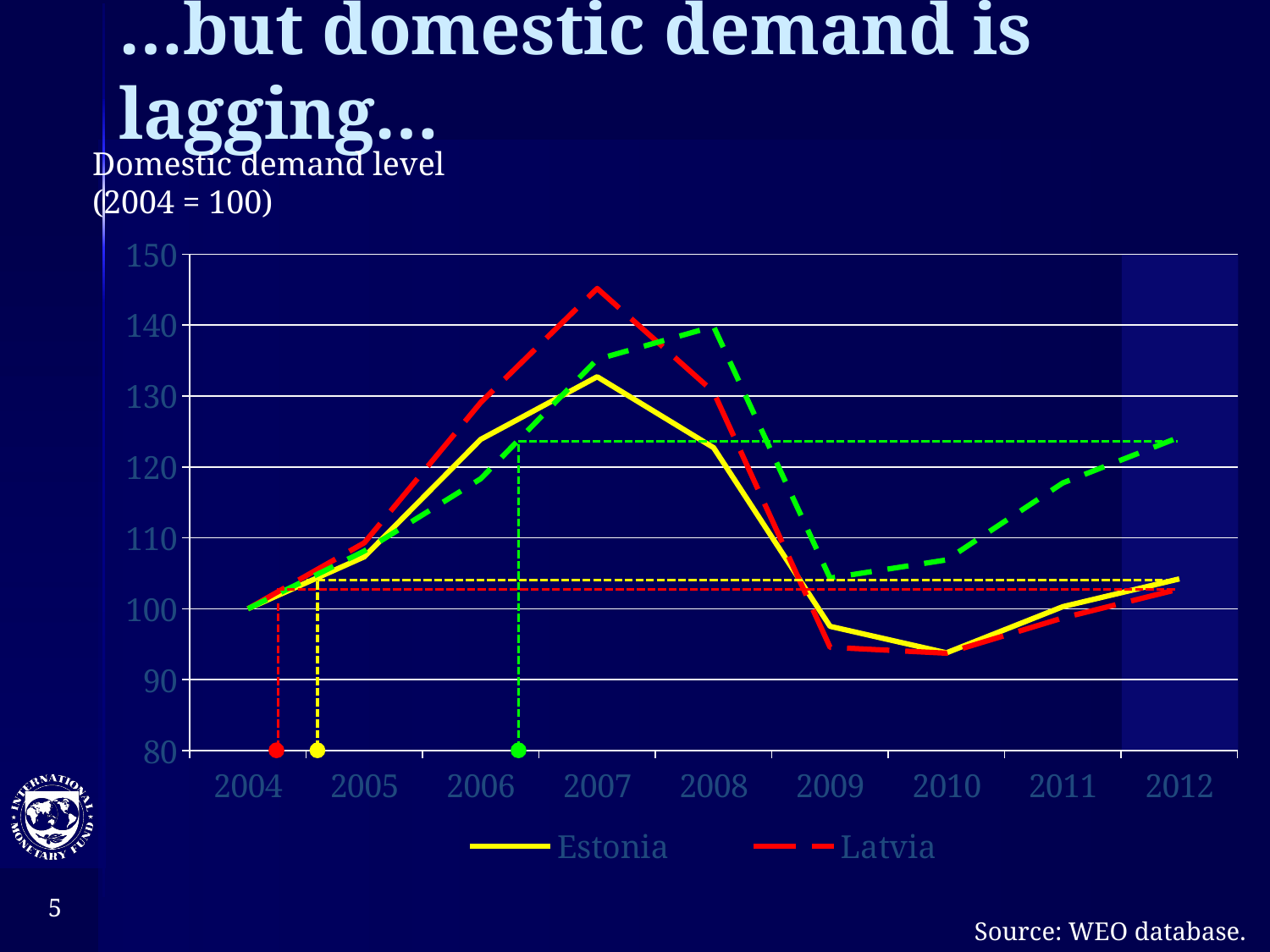
In which year is Estonia's domestic demand level at its lowest? 2010 In which year does Estonia's domestic demand level reach its highest point? 2007 How many series does the chart legend list? 2 In 2007, which series has the higher domestic demand level, Estonia or Latvia? Latvia What source is cited for the chart data? WEO database What kind of chart is shown on the slide? line chart Is the value for Latvia in 2007 greater or less than 140? greater Is the value for Estonia in 2010 greater or less than 100? less What is the domestic demand level for Estonia in 2004? 100 Does Estonia's domestic demand level rise or fall between 2007 and 2010? fall How many years are shown on the x axis of the chart? 9 In which year does Latvia's domestic demand level reach its highest point? 2007